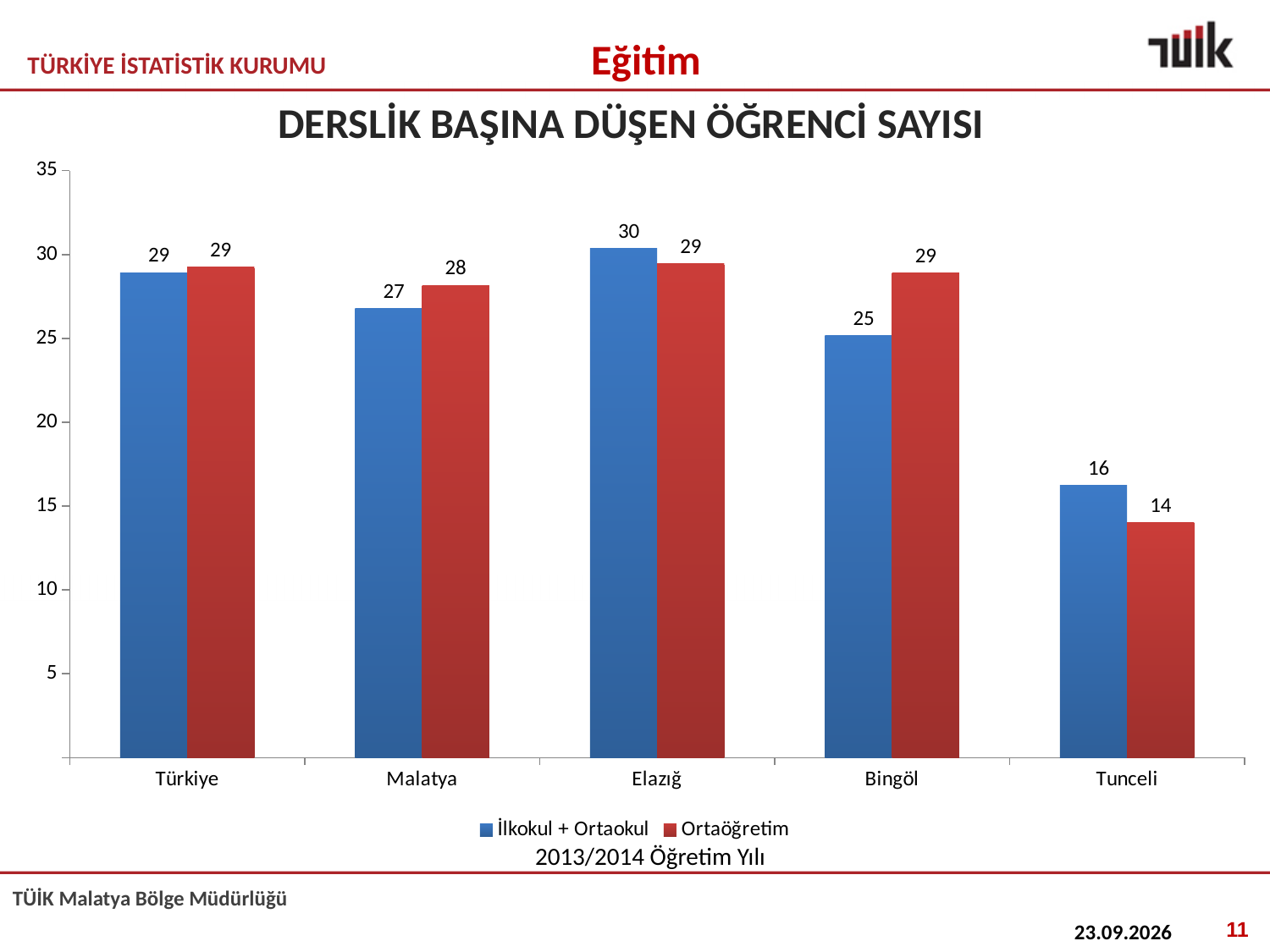
What is the difference between the Ortaöğretim and İlkokul + Ortaokul values for Bingöl? 4 Which category has the lowest Ortaöğretim value? Tunceli Which category has the highest İlkokul + Ortaokul value? Elazığ How many series does the legend list? 2 What is the title of the chart? DERSLİK BAŞINA DÜŞEN ÖĞRENCİ SAYISI How many categories are shown on the x axis? 5 What is the value for İlkokul + Ortaokul in Elazığ? 30 What kind of chart is shown on the slide? Bar chart What is the value for Ortaöğretim in Tunceli? 14 What is the value for Ortaöğretim in Malatya? 28 Which is larger in Tunceli: İlkokul + Ortaokul or Ortaöğretim? İlkokul + Ortaokul What is the value for İlkokul + Ortaokul in Bingöl? 25